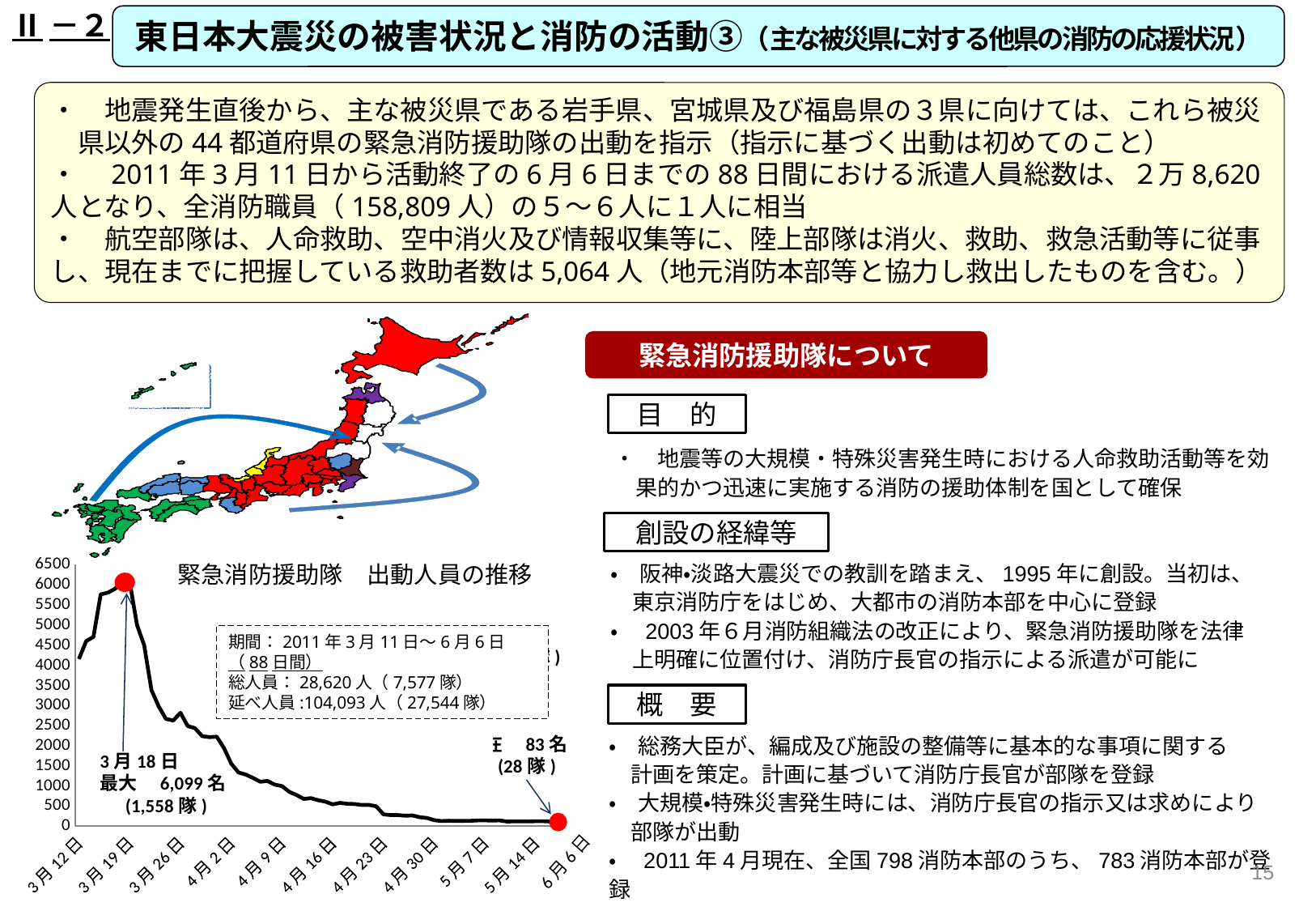
What kind of chart is the chart titled 緊急消防援助隊 出動人員の推移? line chart What is the number of personnel shown at the end of the chart on 6月6日? 83名 Do the values on the chart generally rise or fall from 3月19日 to 6月6日? fall How many teams (隊) are shown for the final point on 6月6日? 28隊 What is the difference between the peak personnel count (6,099名) and the final count on 6月6日 (83名)? 6,016 What is the highest tick value shown on the y-axis of the chart? 6500 What is the title of the chart at the bottom left of the slide? 緊急消防援助隊 出動人員の推移 What is the maximum number of personnel dispatched shown on the chart? 6,099名 On which date did the number of dispatched personnel reach its maximum according to the chart? 3月18日 Is the value for 5月7日 greater or less than 500? less Is the value for 4月2日 greater or less than 2000? less How many teams (隊) were dispatched on the peak day, 3月18日? 1,558隊